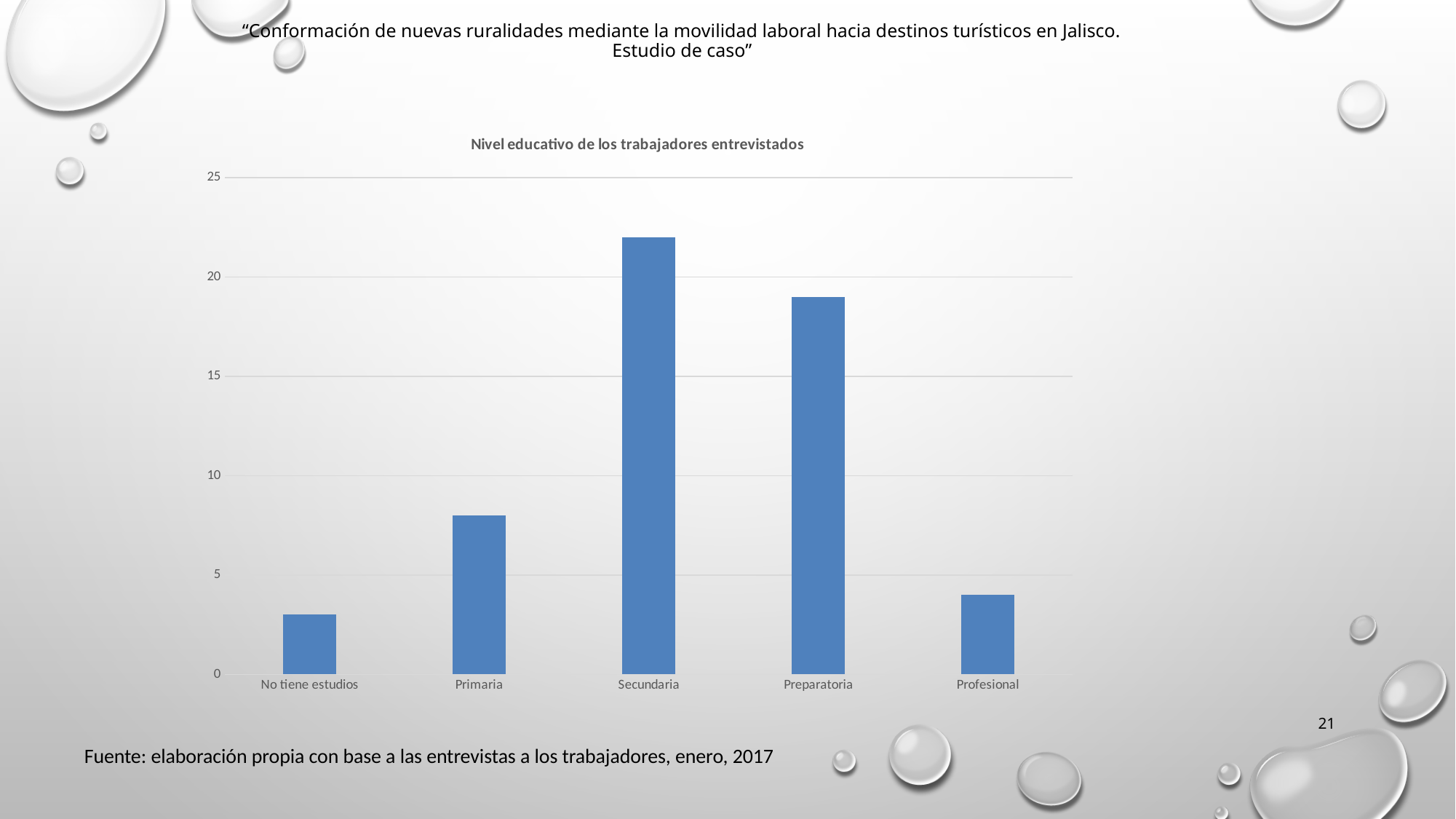
Is the value for Primaria greater or less than 10? less What is the title of the chart? Nivel educativo de los trabajadores entrevistados Is the value for Profesional greater or less than 5? less Which is larger, the value for Secundaria or the value for Preparatoria? Secundaria Which is larger, the value for Primaria or the value for Profesional? Primaria How many education-level categories are shown on the x axis? 5 What type of chart is shown on the slide? Bar chart Is the value for Secundaria greater or less than 20? greater Which category has the highest value? Secundaria Which category has the lowest value? No tiene estudios